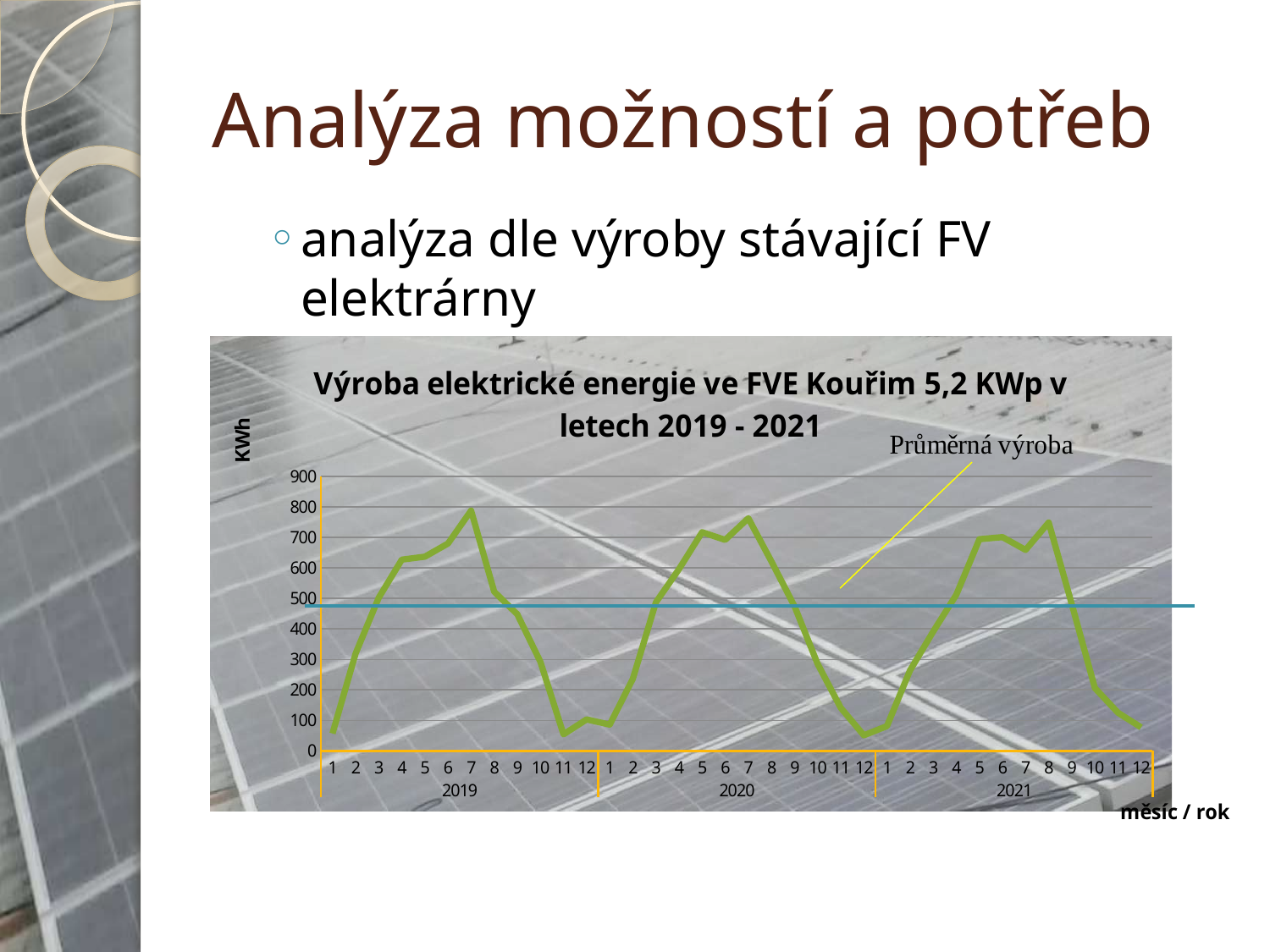
What kind of chart is shown on the slide? line chart Do the values rise or fall from month 7 to month 11 of 2019? fall What label is shown on the vertical axis of the chart? KWh Which month of 2019 has the highest value? 7 How many monthly data points are plotted in the chart in total? 36 Is the value for month 7 of 2019 greater or less than 700? greater What is the title of the chart? Výroba elektrické energie ve FVE Kouřim 5,2 KWp v letech 2019 - 2021 Is the value for month 12 of 2021 greater or less than 200? less How many years are shown along the x axis of the chart? 3 Is the value for month 1 of 2019 greater or less than 200? less Which month of 2021 has the highest value? 8